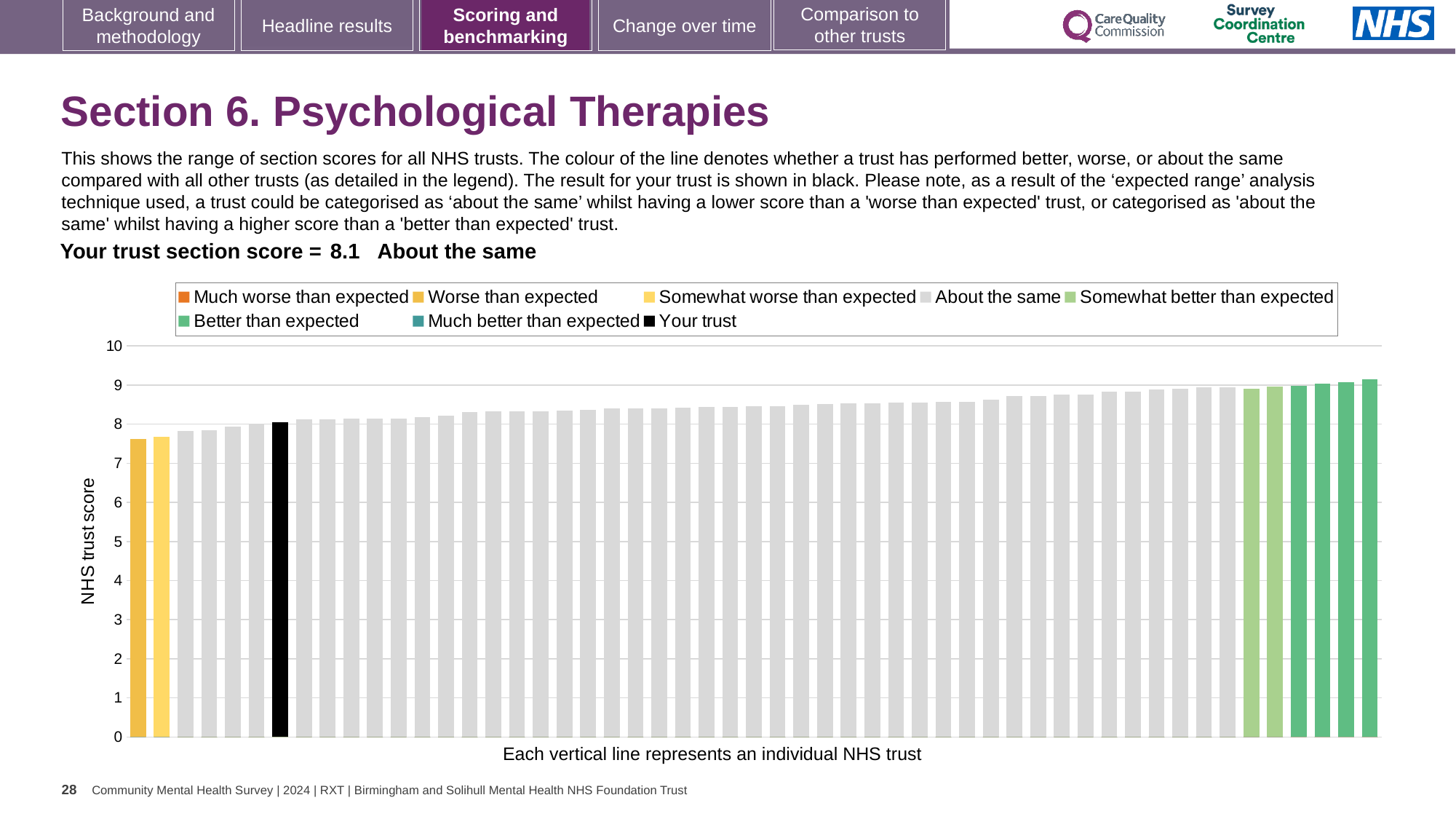
What kind of chart is shown on the slide? bar chart Is the value of the highest bar greater or less than 8? greater What is the section score for your trust shown on the slide? 8.1 What colour is the bar representing your trust? black How many bars are coloured yellow (worse or somewhat worse than expected)? 2 What is the label on the y axis of the chart? NHS trust score Do the bar values rise or fall from left to right along the x axis? rise Is the value of the lowest bar greater or less than 8? less Is the value for your trust greater or less than 5? greater How many entries does the chart legend list? 8 Which is larger, the leftmost bar or the rightmost bar? the rightmost bar Which category is your trust placed in for this section? About the same